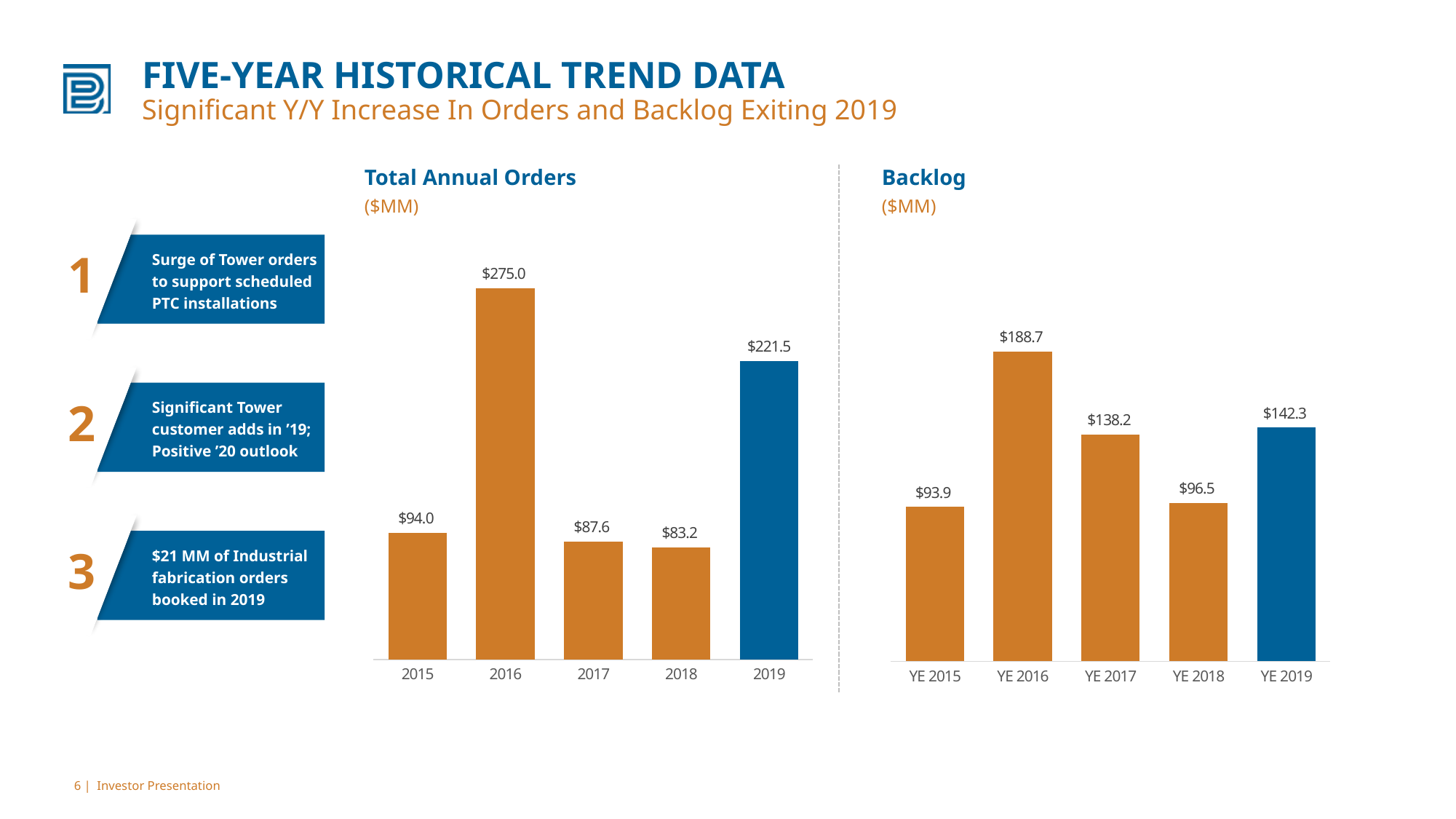
In the Total Annual Orders chart, which year has the lowest value? 2018 In the Backlog chart, what is the value for YE 2017? $138.2 In the Total Annual Orders chart, how many years are shown? 5 In the Total Annual Orders chart, what is the value for 2016? $275.0 In the Backlog chart, which year has the highest value? YE 2016 In the Backlog chart, does the value rise or fall from YE 2018 to YE 2019? rise In the Backlog chart, which year has the lowest value? YE 2015 In the Backlog chart, what is the difference between the YE 2019 and YE 2018 values? $45.8 What kind of chart is the Backlog chart? bar chart In the Total Annual Orders chart, is the value for 2015 larger or smaller than the value for 2017? larger What unit is shown under the title of the Total Annual Orders chart? ($MM) In the Total Annual Orders chart, what is the difference between the 2019 and 2018 values? $138.3